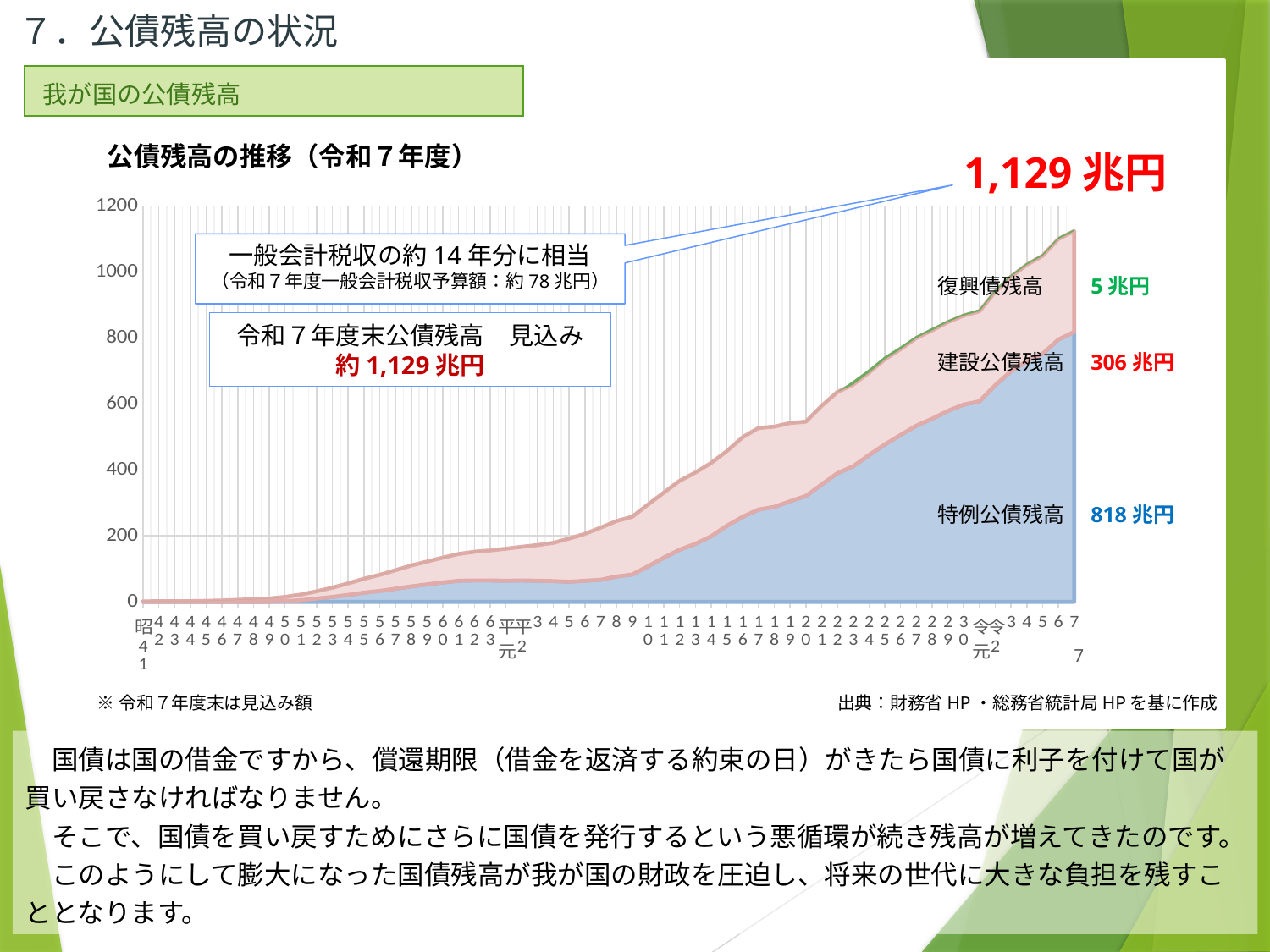
Which bond category has the largest balance at the end of 令和7年度? 特例公債残高 What is the total 公債残高 at the end of 令和7年度? 1,129兆円 What is the value of 建設公債残高 at the end of 令和7年度? 306兆円 What is the value of 特例公債残高 at the end of 令和7年度? 818兆円 What kind of chart is shown on the slide? Stacked area chart Which bond category has the smallest balance at the end of 令和7年度? 復興債残高 What is the value of 復興債残高 at the end of 令和7年度? 5兆円 What is the difference between 特例公債残高 and 建設公債残高 at the end of 令和7年度? 512兆円 How many bond categories (series) are stacked in the chart? 3 Does the total 公債残高 rise or fall over the period shown on the x axis? Rise Which is larger at the end of 令和7年度, 建設公債残高 or 復興債残高? 建設公債残高 What is the chart's title? 公債残高の推移（令和７年度）